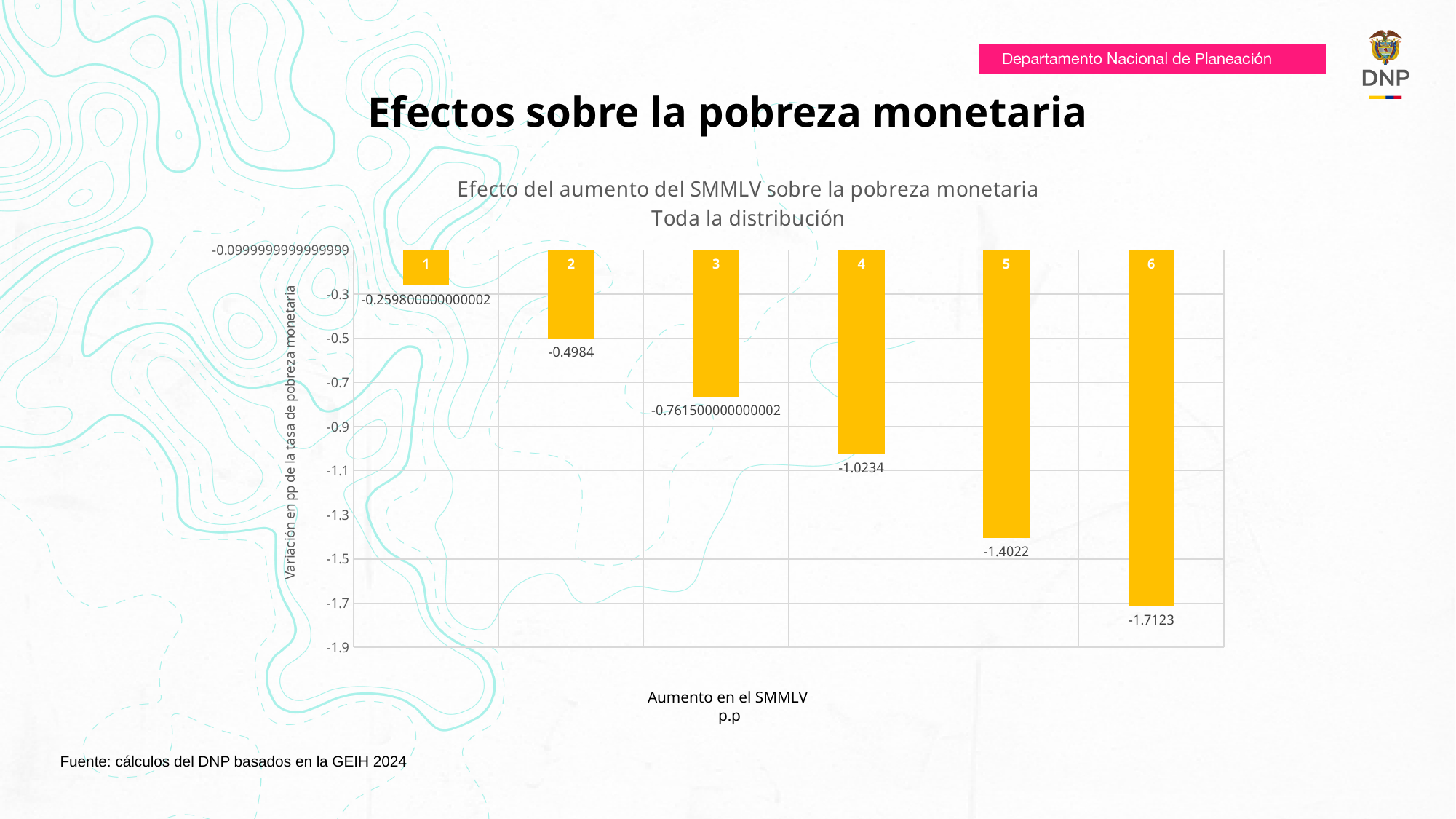
Which has a larger (less negative) value, category 3 or category 5? category 3 What is the difference between the values for category 4 and category 2? 0.525 Which category has the lowest (most negative) value? 6 What is the value for category 2? -0.4984 What is the value for category 6? -1.7123 What is the value for category 4? -1.0234 What kind of chart is shown? bar chart What is the value for category 5? -1.4022 Do the values rise or fall as the category number increases along the x axis? fall What is the difference between the values for category 6 and category 5? 0.3101 How many categories are shown on the x axis? 6 Which category has the highest (least negative) value? 1